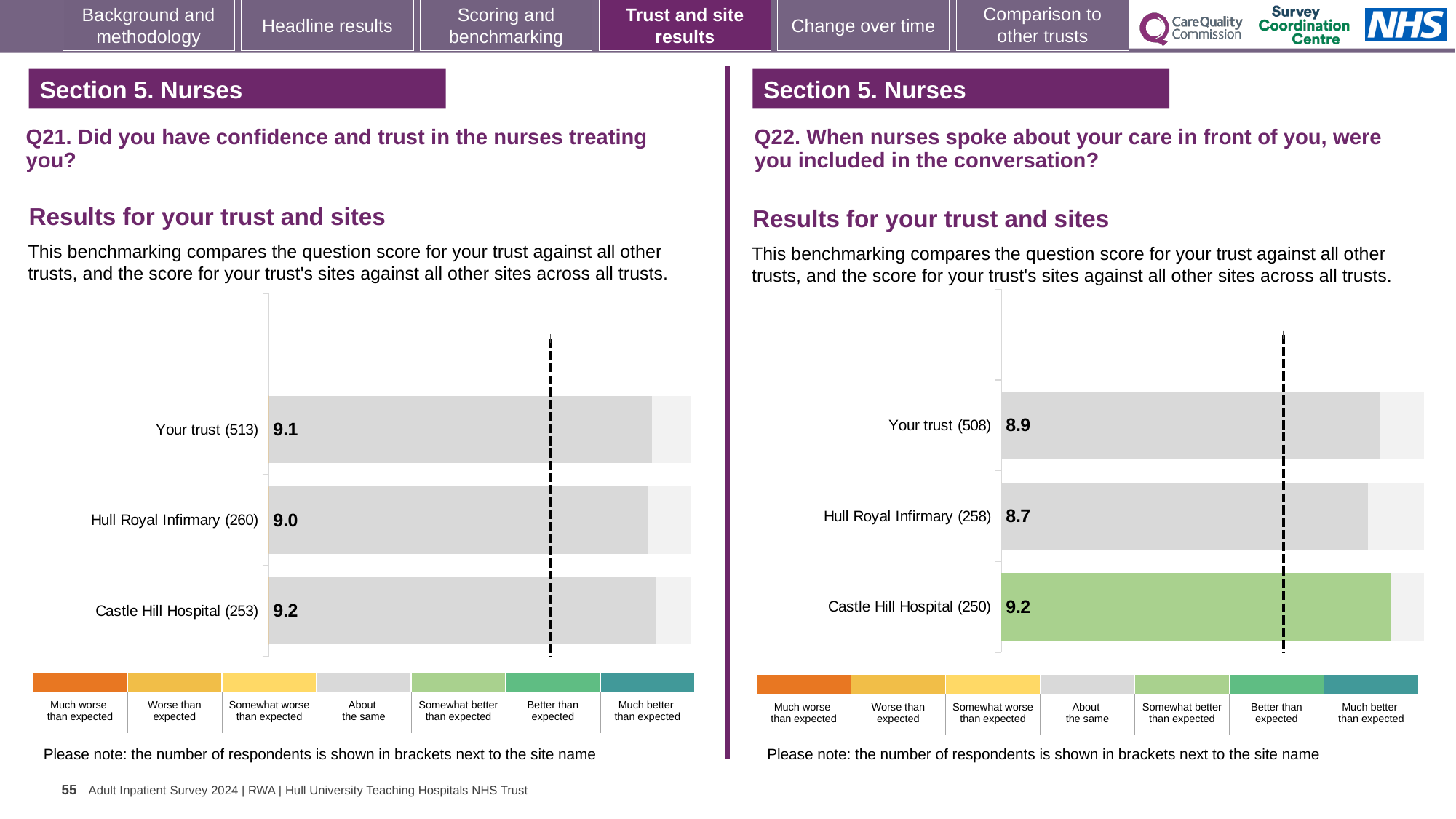
On the Q22 chart (right), is the score for Castle Hill Hospital larger or smaller than the score for Your trust? larger On the Q21 chart (left), what is the score for Castle Hill Hospital? 9.2 On the Q21 chart (left), what is the difference between the Castle Hill Hospital score and the Hull Royal Infirmary score? 0.2 On the Q22 chart (right), what is the score for Hull Royal Infirmary? 8.7 On the Q22 chart (right), how many respondents are shown in brackets for Castle Hill Hospital? 250 What kind of chart is used on the Q21 chart (left)? bar chart On the Q22 chart (right), which site or trust has the highest score? Castle Hill Hospital On the Q22 chart (right), what is the score for Your trust? 8.9 On the Q21 chart (left), which site or trust has the lowest score? Hull Royal Infirmary On the Q21 chart (left), how many bars are plotted? 3 On the Q22 chart (right), what is the difference between the Castle Hill Hospital score and the Hull Royal Infirmary score? 0.5 On the Q21 chart (left), what is the score for Your trust? 9.1